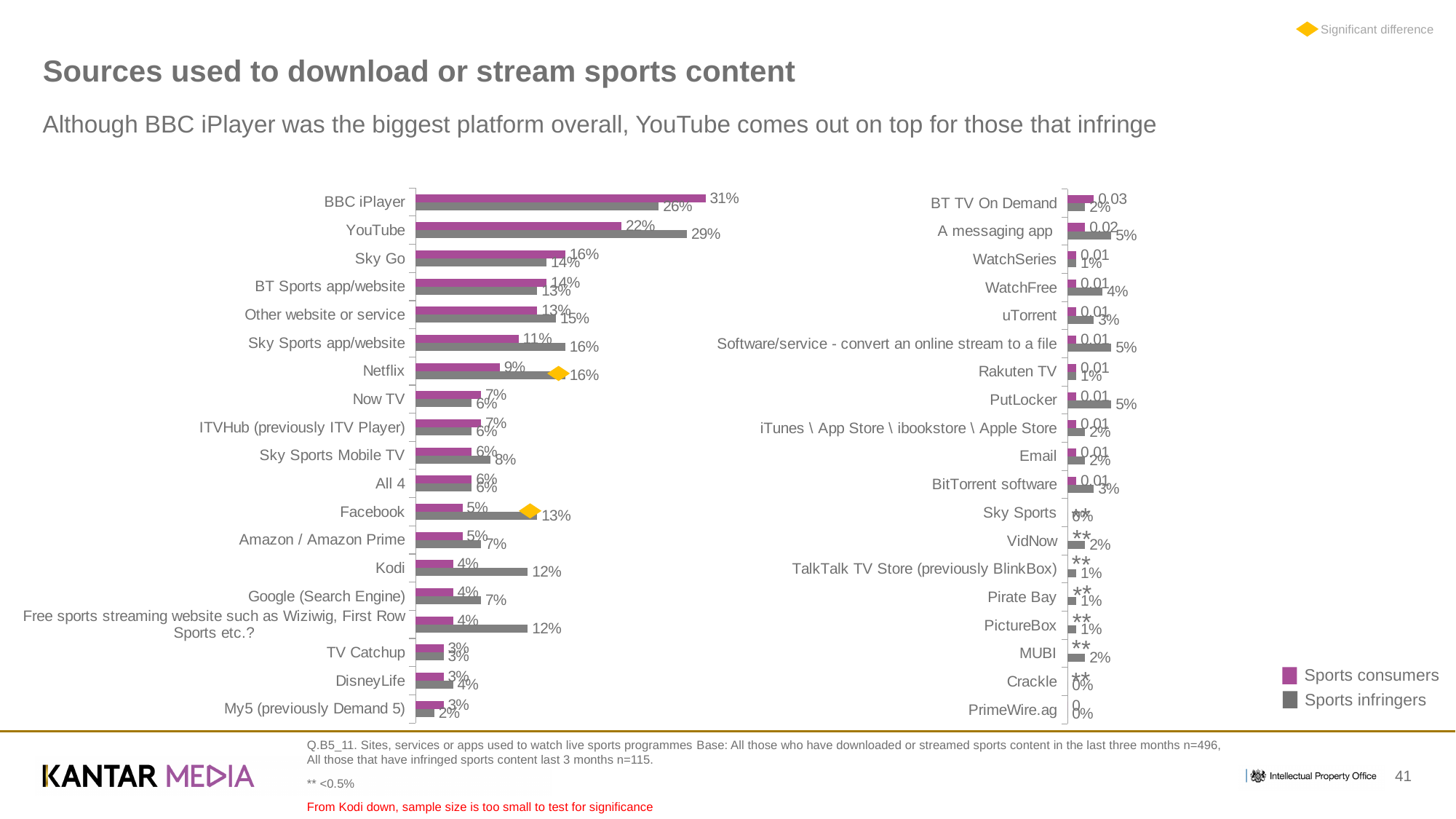
In the left chart, which is larger for Facebook: the Sports consumers value or the Sports infringers value? Sports infringers In the left chart, what is the Sports consumers value for BBC iPlayer? 31% How many series does the legend list? 2 In the left chart, which source has the highest Sports infringers value? YouTube How many sources are listed in the left chart? 19 In the left chart, what is the difference between the Sports infringers and Sports consumers values for Netflix? 7% In the right chart, what is the Sports infringers value for PutLocker? 5% What type of chart is used on this slide? Bar chart In the left chart, what is the Sports infringers value for YouTube? 29% In the right chart, what is the Sports infringers value for WatchFree? 4% In the left chart, what is the Sports infringers value for Kodi? 12% In the left chart, what is the Sports consumers value for Sky Sports app/website? 11%